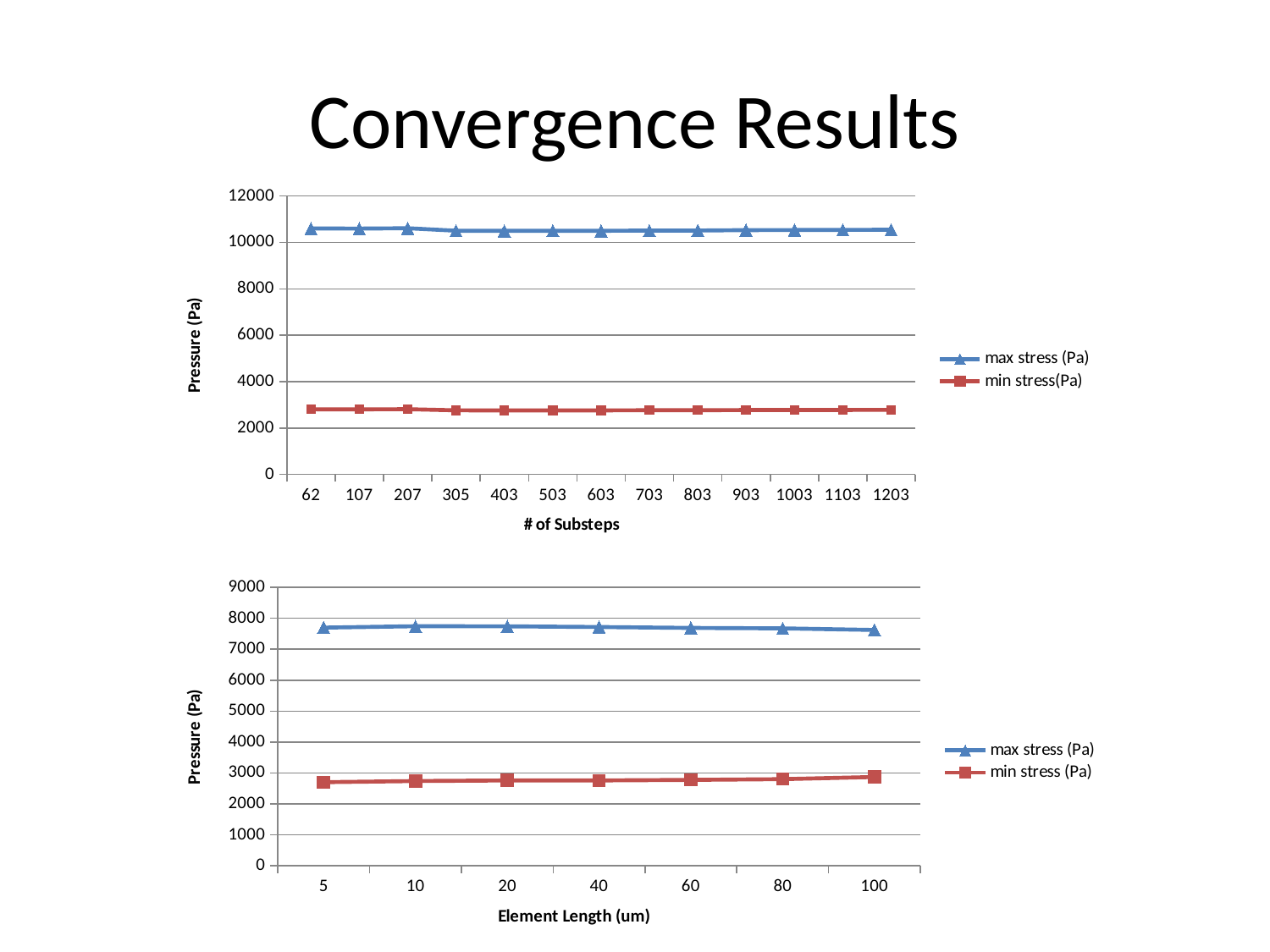
What kind of chart is the bottom chart on the slide? line chart In the top chart (# of Substeps), how many substep values are shown on the x axis? 13 In the bottom chart (Element Length), how many points are plotted along the x axis for each series? 7 What is the y-axis title of the bottom chart? Pressure (Pa) In the bottom chart (Element Length), is the min stress (Pa) value at element length 100 greater or less than 4000? less In the bottom chart (Element Length), which series has the larger values, max stress (Pa) or min stress (Pa)? max stress (Pa) In the top chart (# of Substeps), how many series does the legend list? 2 In the bottom chart (Element Length), is the max stress (Pa) value at element length 5 greater or less than 7000? greater What kind of chart is the top chart on the slide? line chart In the top chart (# of Substeps), is the max stress (Pa) value at 62 substeps greater or less than 10000? greater What is the x-axis title of the top chart? # of Substeps